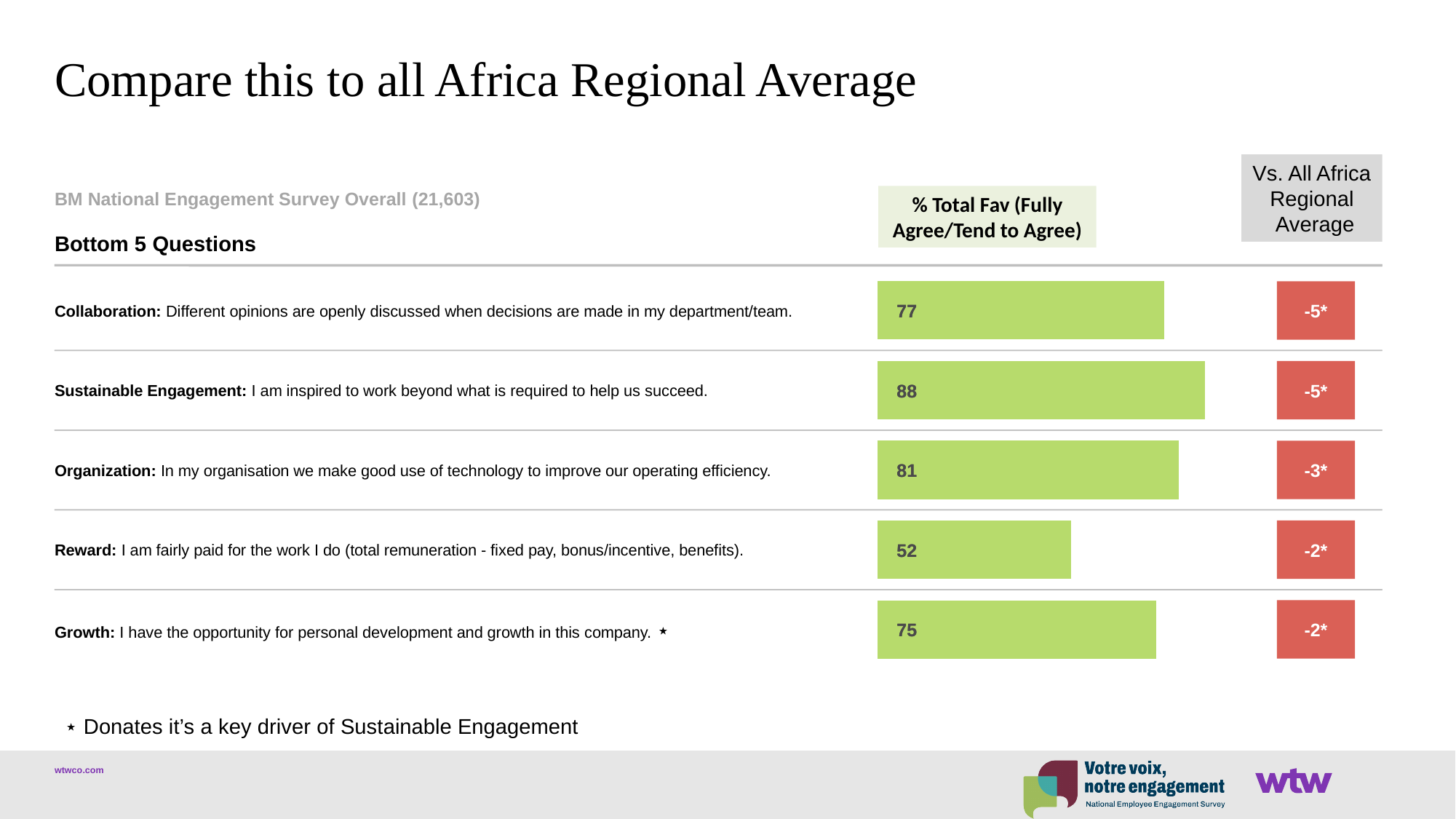
Which question has the lowest % Total Fav value? Reward What is the Vs. All Africa Regional Average value for Organization? -3* What kind of chart is used to show the % Total Fav values? Bar chart Which question has the highest % Total Fav value? Sustainable Engagement What is the difference between the % Total Fav values for Collaboration and Growth? 2 What is the % Total Fav value for Growth? 75 What is the difference between the % Total Fav values for Sustainable Engagement and Reward? 36 Which has a higher % Total Fav value, Organization or Growth? Organization What is the % Total Fav value for Reward? 52 How many questions are shown in the chart? 5 What is the % Total Fav value for Collaboration? 77 What colour are the bars showing the % Total Fav values? Green